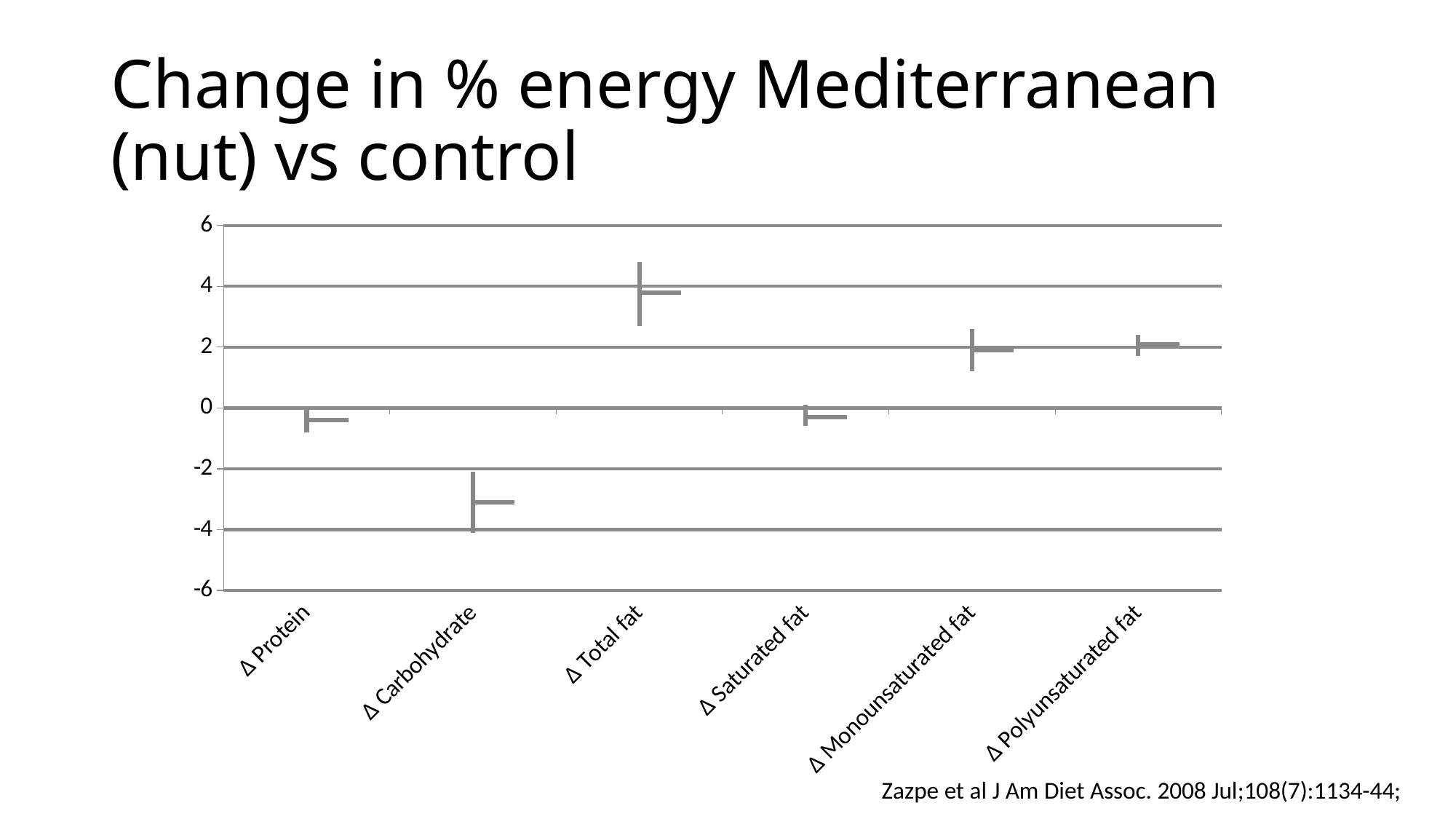
Is the value for Δ Polyunsaturated fat greater or less than 4? less Which is larger, the value for Δ Total fat or the value for Δ Carbohydrate? Δ Total fat Is the value for Δ Monounsaturated fat greater or less than 0? greater Is the value for Δ Carbohydrate greater or less than -2? less Which category has the highest value? Δ Total fat What is the title of the slide? Change in % energy Mediterranean (nut) vs control How many categories are shown on the x axis? 6 What kind of chart is shown on the slide? stock chart (high-low-close) Which is larger, the value for Δ Protein or the value for Δ Carbohydrate? Δ Protein Which category has the lowest value? Δ Carbohydrate